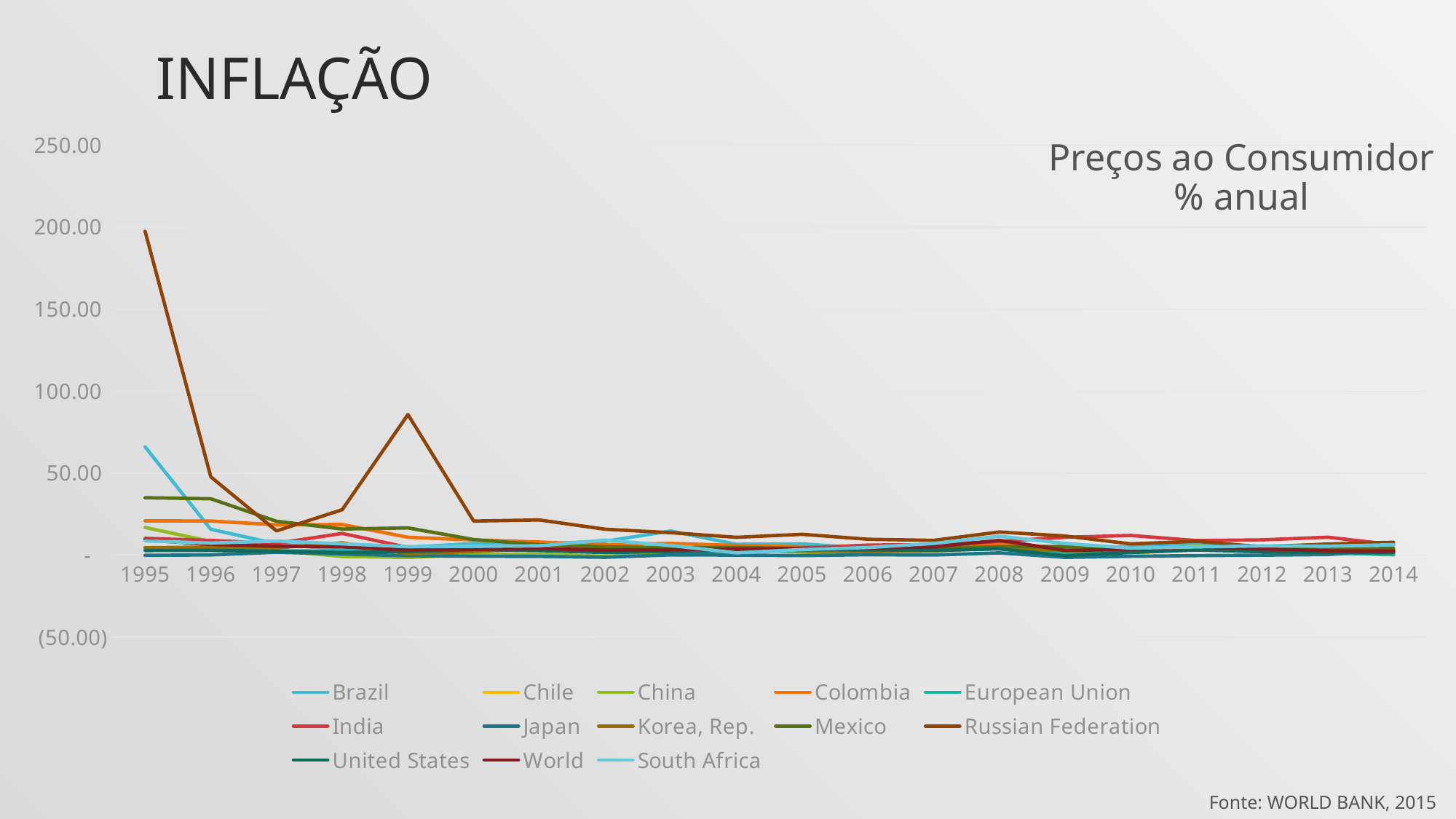
What kind of chart is shown on the slide? line chart Is the value for Brazil in 1995 greater or less than 50? greater In 1995, which is larger: the value for Russian Federation or the value for Brazil? Russian Federation Is the value for Russian Federation in 2000 greater or less than 50? less Is the value for Mexico in 1995 greater or less than 50? less Does the Russian Federation line overall rise or fall from 1995 to 2014? fall How many years are shown along the x axis? 20 Which series has the highest value in 1995? Russian Federation What is the title of the slide? INFLAÇÃO How many series does the legend list? 13